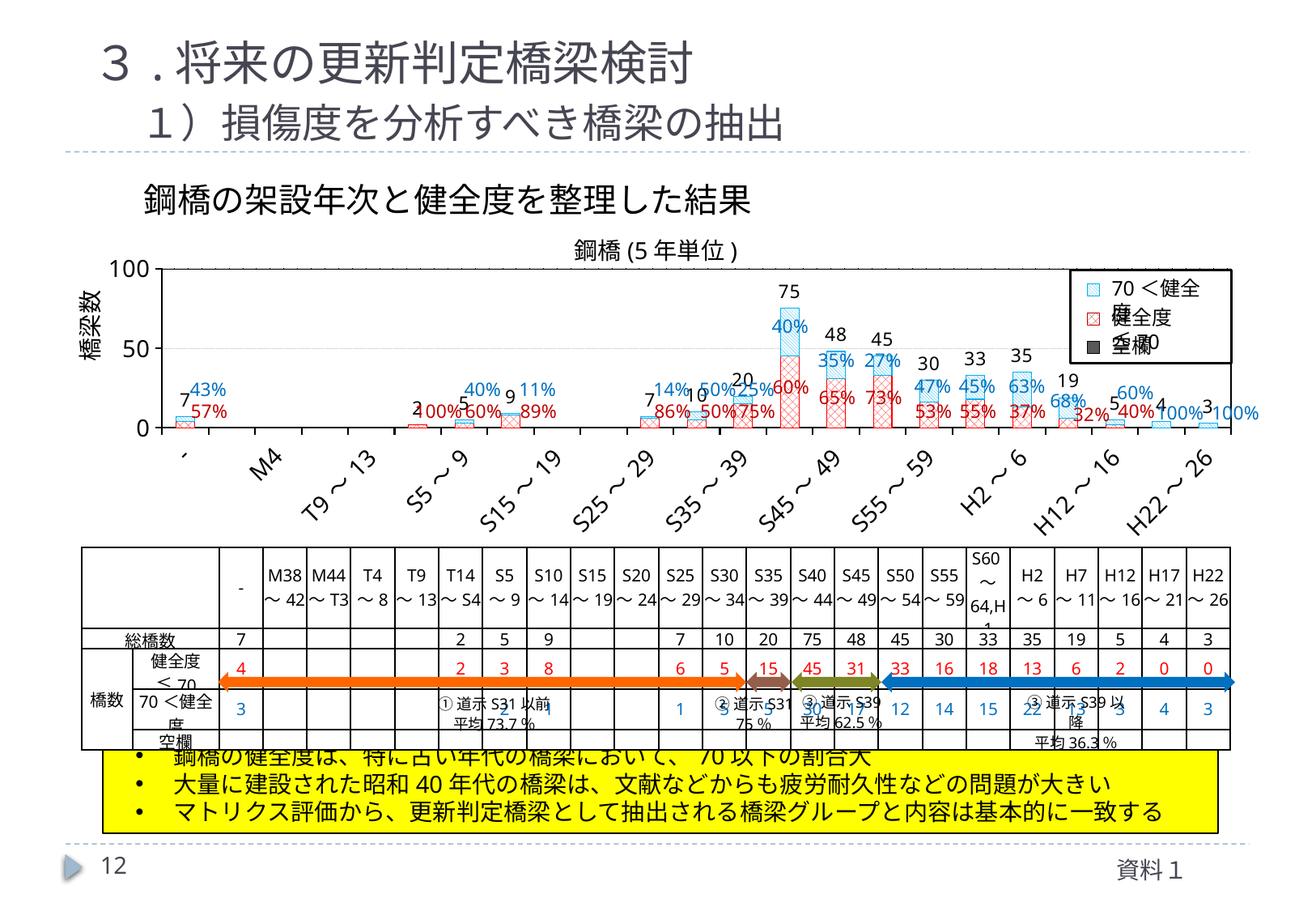
What is the total number of bridges for the period S45～49? 48 How many series does the chart legend list? 3 What is the title of the chart? 鋼橋(5年単位) Which period has more bridges in total, H2～6 or S55～59? H2～6 What percentage is shown for the 70＜健全度 portion of the H2～6 bar? 63% What is the difference between the total number of bridges for S45～49 and for S55～59? 18 What kind of chart is shown on the slide? stacked bar chart What is the total number of bridges for the period H22～26? 3 What percentage is shown for the 健全度＜70 portion of the S35～39 bar? 75% What is the total number of bridges for the period H2～6? 35 What is the highest total number of bridges shown for any period in the chart? 75 Which period has the highest total number of bridges in the chart? S40～44